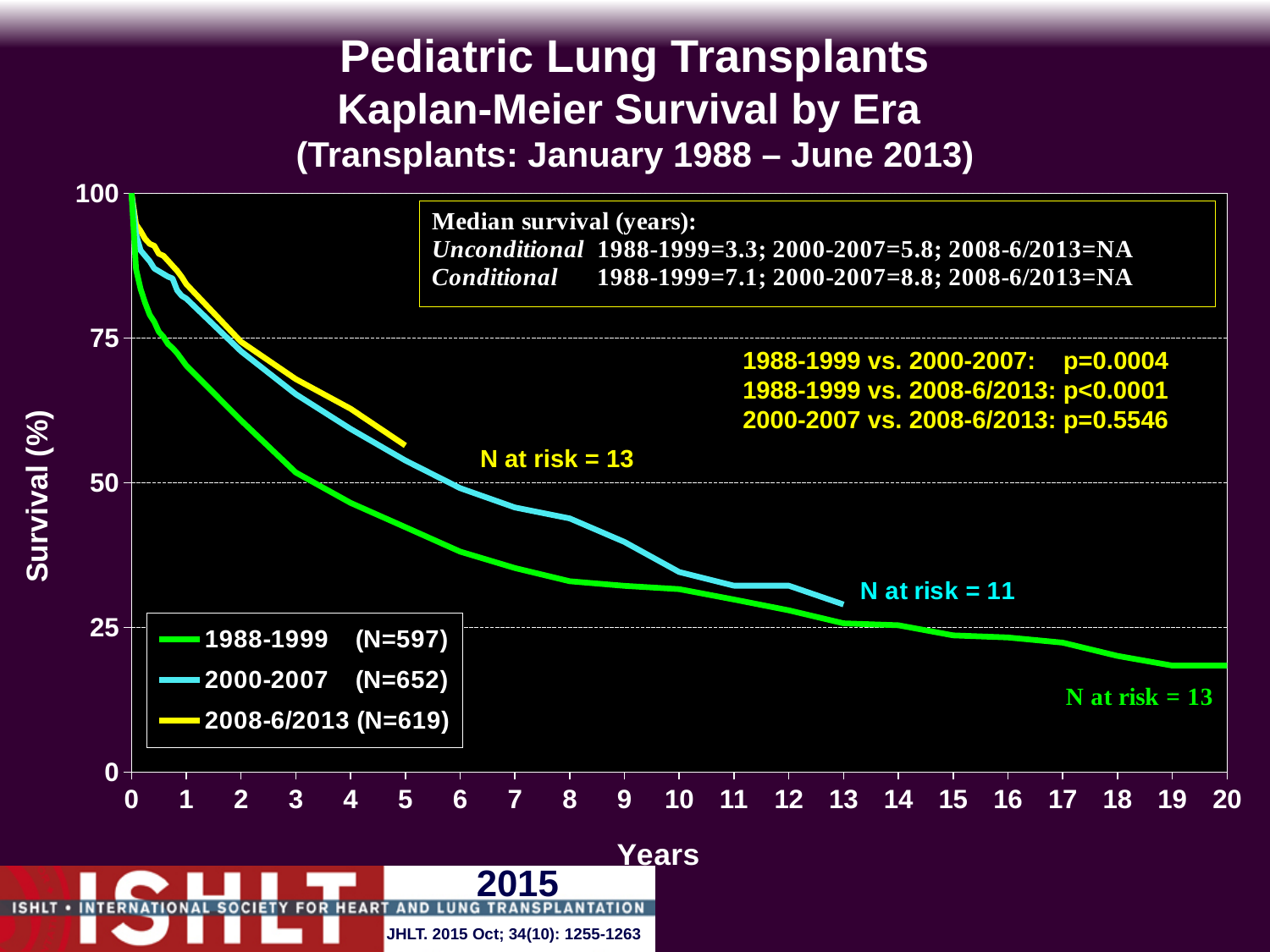
What is the conditional median survival in years for the 1988-1999 era? 7.1 What is the unconditional median survival in years for the 2000-2007 era? 5.8 What kind of chart is shown on the slide? line chart Is the survival value for the 1988-1999 era at 10 years greater or less than 50? less How many series (eras) does the legend list? 3 What is the N at risk shown at the end of the 2000-2007 curve? 11 Is the survival value for the 2008-6/2013 era at 5 years greater or less than 50? greater What is the label on the y axis? Survival (%) What is the N for the 2000-2007 era shown in the legend? N=652 Do the survival curves rise or fall as years increase along the x axis? fall At 5 years, which era has higher survival: 1988-1999 or 2008-6/2013? 2008-6/2013 What p-value is given for 1988-1999 vs. 2000-2007? p=0.0004